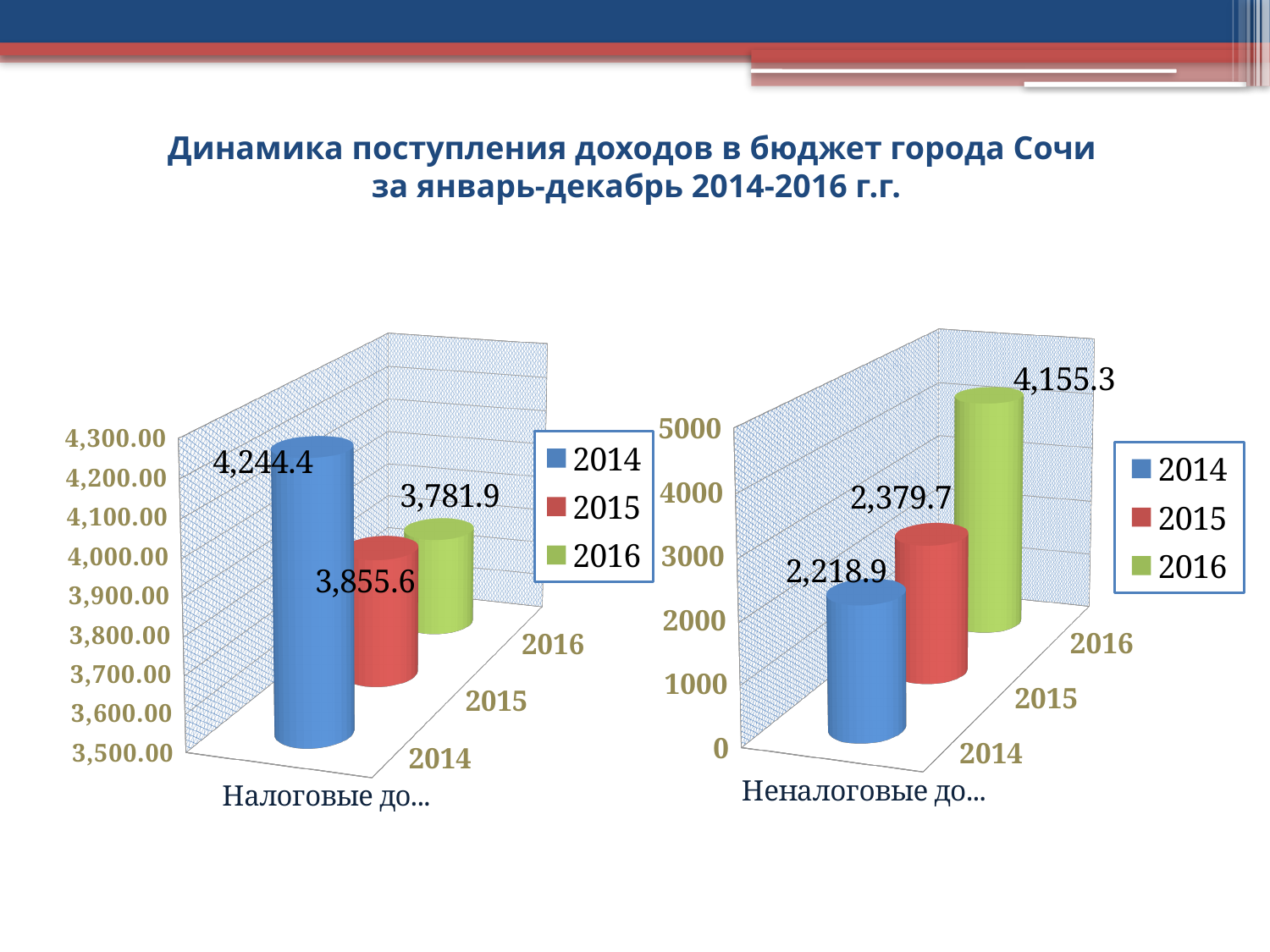
In the left chart, what is the value for 2016? 3,781.9 In the left chart, what is the difference between the 2014 and 2015 values? 388.8 In the left chart, what is the value for 2014? 4,244.4 In the right chart, what is the value for 2016? 4,155.3 In the right chart, which is larger, the value for 2015 or the value for 2014? 2015 How many series does the legend of the right chart list? 3 In the right chart, what is the value for 2015? 2,379.7 In the left chart, which year has the highest value? 2014 What kind of chart is the left chart? bar chart In the right chart, which year has the lowest value? 2014 In the right chart, what is the difference between the 2016 and 2015 values? 1,775.6 In the left chart, do the values rise or fall from 2014 to 2016? fall